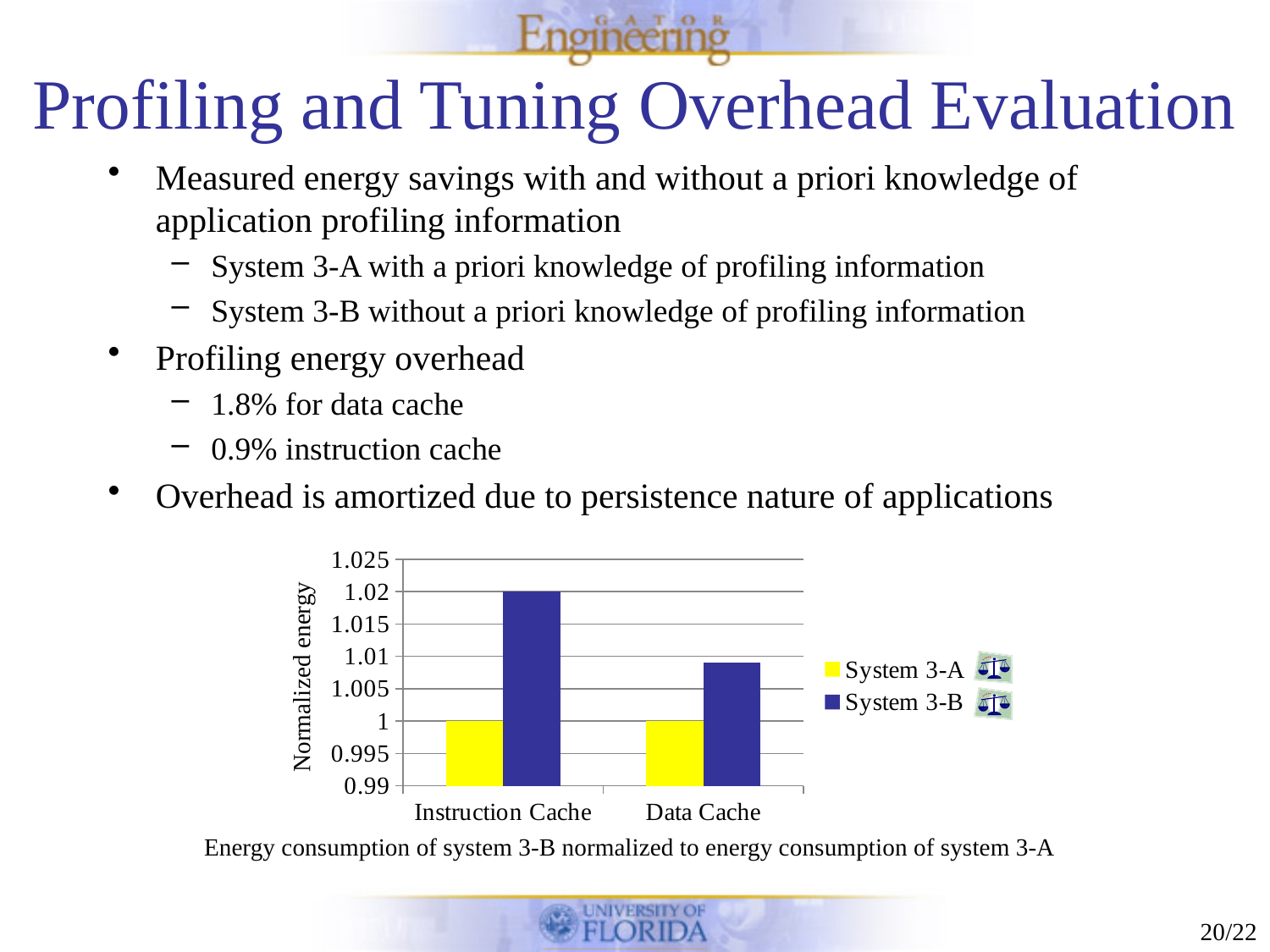
What is the normalized energy value for System 3-A for Data Cache? 1 For Instruction Cache, which series has the larger value, System 3-A or System 3-B? System 3-B What kind of chart is shown on the slide? bar chart For Instruction Cache, what is the difference between the System 3-B value and the System 3-A value? 0.02 How many categories are shown on the x axis of the chart? 2 What is the normalized energy value for System 3-B for Instruction Cache? 1.02 Is the value for System 3-B for Data Cache greater or less than 1.005? greater What is the normalized energy value for System 3-A for Instruction Cache? 1 How many series does the chart's legend list? 2 For which category is the System 3-B value highest? Instruction Cache What is the label of the chart's y axis? Normalized energy Is the value for System 3-B for Data Cache greater or less than 1.015? less